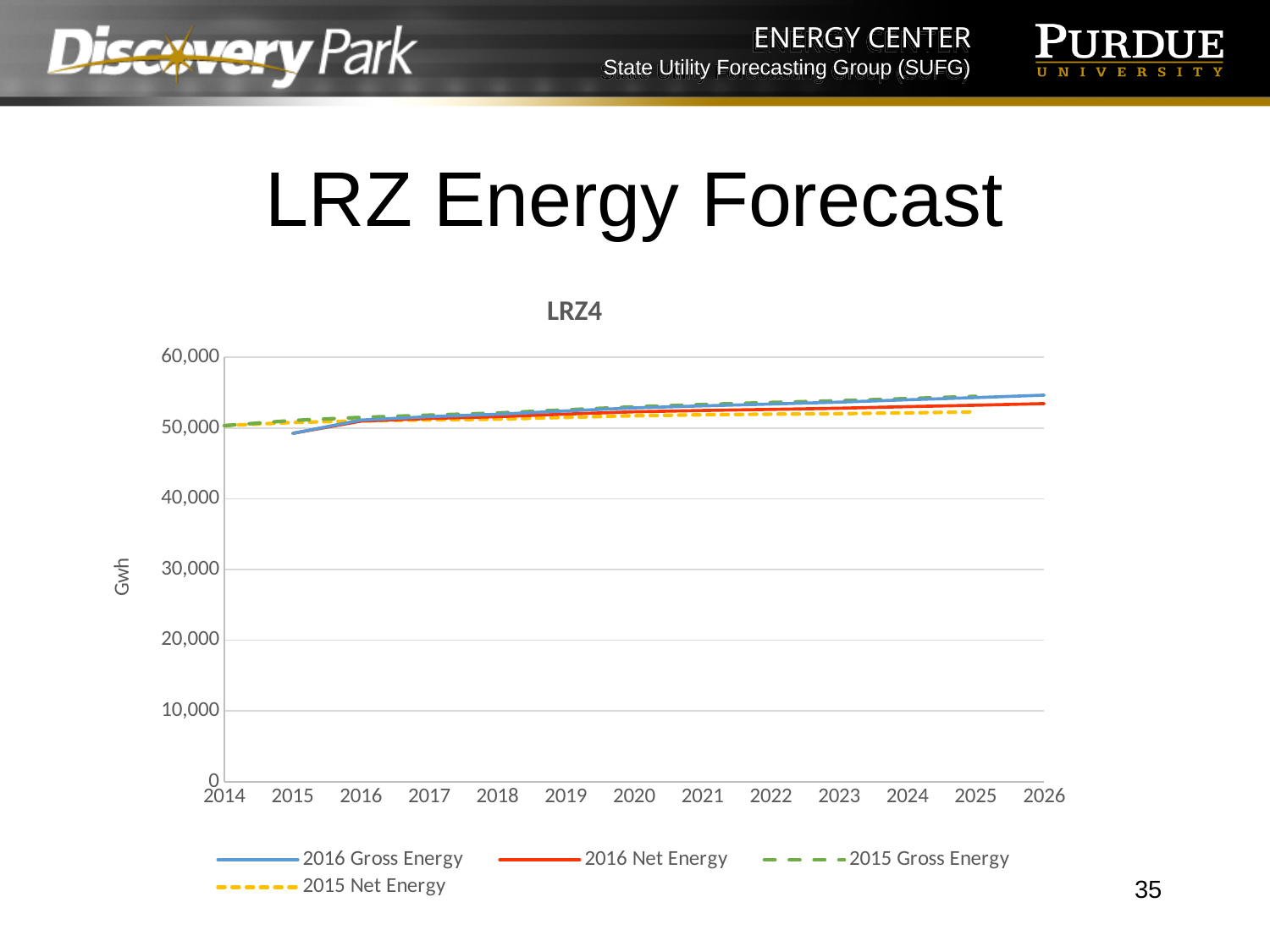
Do the 2016 Gross Energy values rise or fall from 2015 to 2026? Rise Is the value for 2016 Gross Energy in 2015 greater or less than 50,000? less Is the value for 2016 Gross Energy in 2026 greater or less than 50,000? greater What is the title of the chart? LRZ4 What unit is shown on the y-axis label of the chart? Gwh How many years are labelled along the x axis of the chart? 13 What kind of chart is shown on the slide? Line chart Which series has the lowest value in 2015? 2016 Gross Energy and 2016 Net Energy (tied) In 2026, which is larger: 2016 Gross Energy or 2016 Net Energy? 2016 Gross Energy Is the value for 2015 Net Energy in 2025 greater or less than 60,000? less How many series does the legend of the LRZ4 chart list? 4 Which series has the highest value in 2026? 2016 Gross Energy